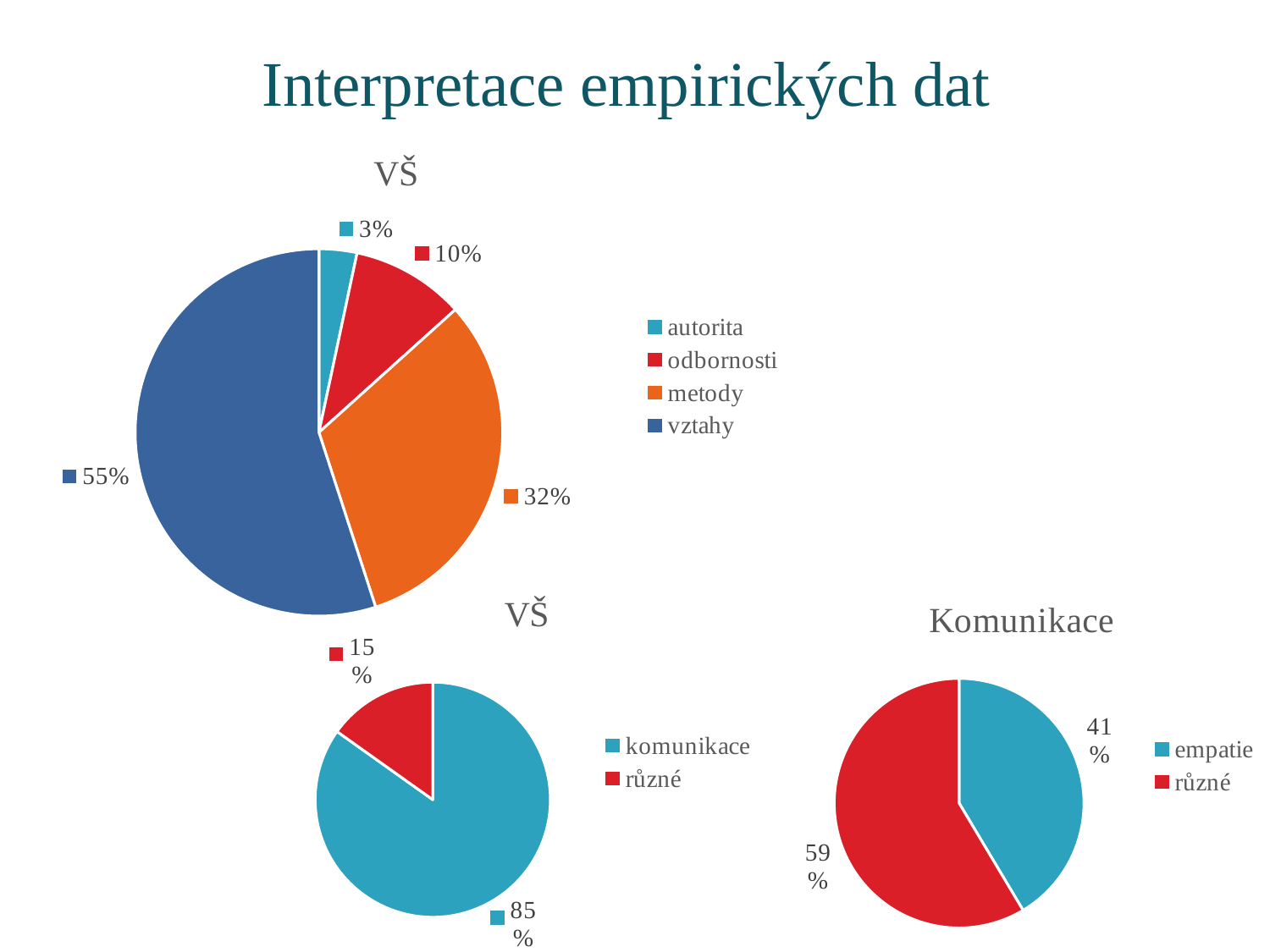
In the bottom-left pie chart titled VŠ, which is larger, komunikace or různé? komunikace In the top pie chart titled VŠ, which category has the smallest share? autorita In the top pie chart titled VŠ, what share does metody have? 32% How many categories does the legend of the top pie chart titled VŠ list? 4 What type of chart is the chart titled Komunikace? pie chart In the pie chart titled Komunikace, what is the difference between the shares of různé and empatie? 18% In the top pie chart titled VŠ, what share does vztahy have? 55% In the bottom-left pie chart titled VŠ, what share does komunikace have? 85% In the pie chart titled Komunikace, which category has the largest share? různé In the pie chart titled Komunikace, what share does empatie have? 41% In the top pie chart titled VŠ, what is the difference between the shares of metody and odbornosti? 22% In the top pie chart titled VŠ, which category has the largest share? vztahy